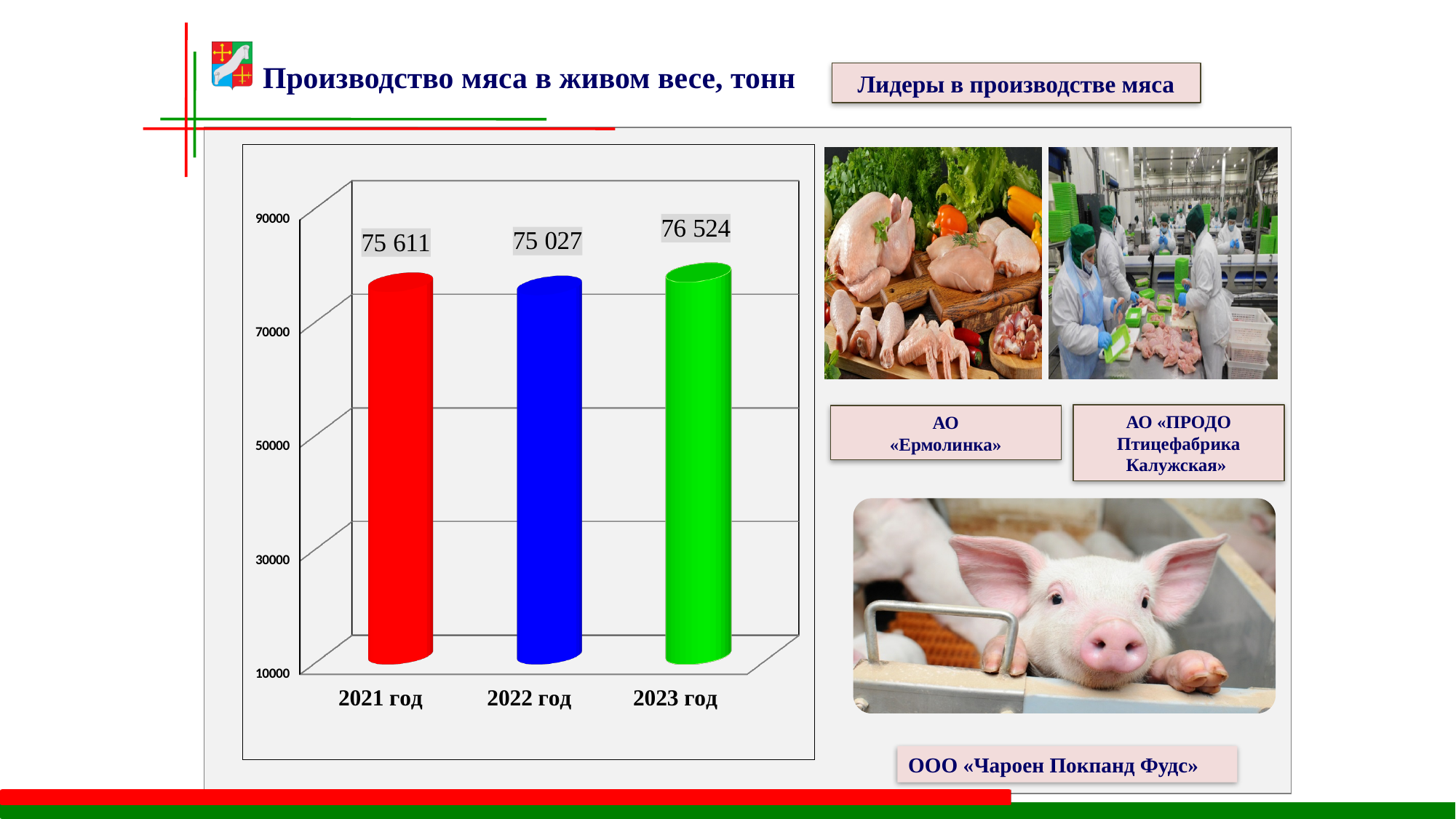
By how much did meat production in 2023 exceed that of 2022? 1 497 Is the value for 2022 greater or less than 70000? greater What colour is the bar for 2023? green Which year had the lowest meat production? 2022 год How many years are shown on the chart? 3 What was meat production in live weight in 2021? 75 611 What was meat production in live weight in 2022? 75 027 What is the difference between meat production in 2021 and 2022? 584 What was meat production in live weight in 2023? 76 524 Which year had the highest meat production? 2023 год Which is larger, meat production in 2021 or in 2023? 2023 What kind of chart is used to show meat production? bar chart